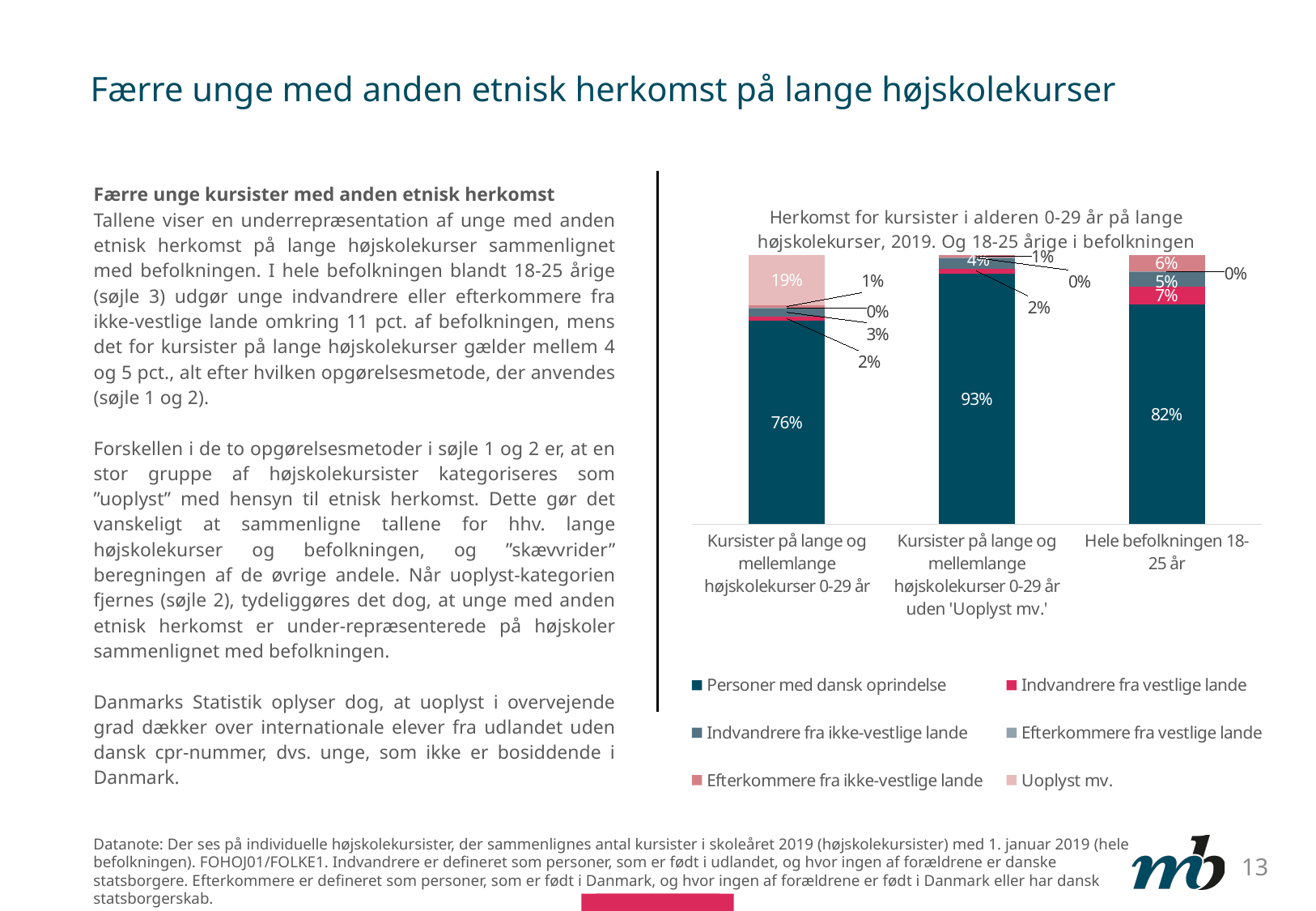
Which category has the lowest share of 'Personer med dansk oprindelse'? Kursister på lange og mellemlange højskolekurser 0-29 år What is the share of 'Uoplyst mv.' for 'Kursister på lange og mellemlange højskolekurser 0-29 år'? 19% Which has a larger share of 'Personer med dansk oprindelse': 'Hele befolkningen 18-25 år' or 'Kursister på lange og mellemlange højskolekurser 0-29 år'? Hele befolkningen 18-25 år What is the share of 'Indvandrere fra vestlige lande' for 'Hele befolkningen 18-25 år'? 7% What is the title of the chart? Herkomst for kursister i alderen 0-29 år på lange højskolekurser, 2019. Og 18-25 årige i befolkningen How many categories (bars) are shown on the x axis of the chart? 3 What is the difference in the share of 'Personer med dansk oprindelse' between 'Kursister på lange og mellemlange højskolekurser 0-29 år uden 'Uoplyst mv.'' and 'Kursister på lange og mellemlange højskolekurser 0-29 år'? 17 percentage points What is the share of 'Personer med dansk oprindelse' for 'Hele befolkningen 18-25 år'? 82% What kind of chart is shown on the slide? Stacked bar chart What is the share of 'Personer med dansk oprindelse' for 'Kursister på lange og mellemlange højskolekurser 0-29 år uden 'Uoplyst mv.''? 93% Which category has the highest share of 'Personer med dansk oprindelse'? Kursister på lange og mellemlange højskolekurser 0-29 år uden 'Uoplyst mv.' How many series does the chart's legend list? 6